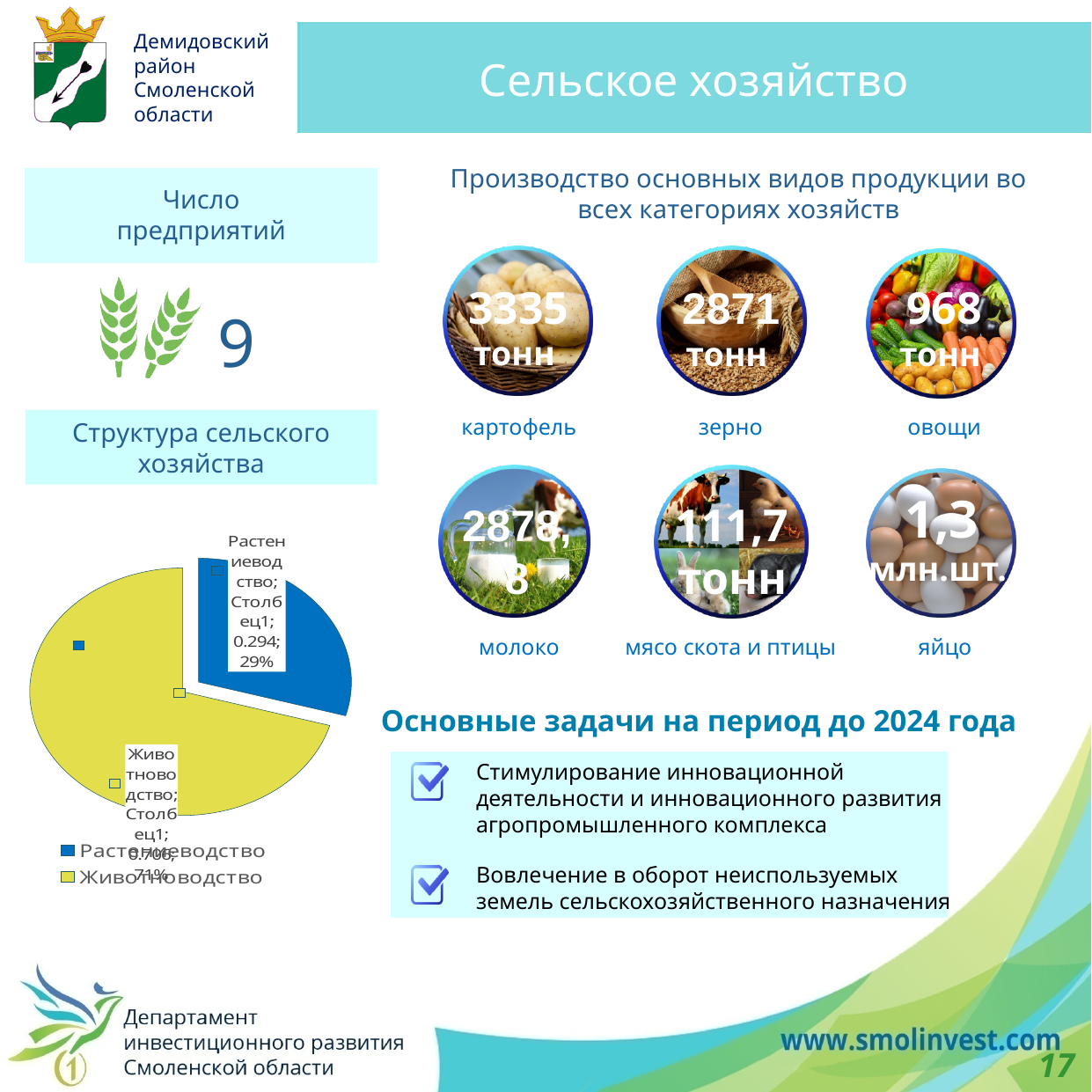
In the pie chart "Структура сельского хозяйства", what share does Животноводство have? 71% In the pie chart "Структура сельского хозяйства", what decimal value is shown in the data label for Растениеводство? 0.294 In the pie chart "Структура сельского хозяйства", by how many percentage points does Животноводство exceed Растениеводство? 42 In the pie chart "Структура сельского хозяйства", which is larger: Растениеводство or Животноводство? Животноводство What kind of chart is shown under the heading "Структура сельского хозяйства"? pie chart In the pie chart "Структура сельского хозяйства", what share does Растениеводство have? 29% Which slice of the pie chart "Структура сельского хозяйства" is the largest? Животноводство In the pie chart "Структура сельского хозяйства", what colour is the Растениеводство slice? blue In the pie chart "Структура сельского хозяйства", what colour is the Животноводство slice? yellow Which slice of the pie chart "Структура сельского хозяйства" is the smallest? Растениеводство How many slices does the pie chart "Структура сельского хозяйства" have? 2 How many entries does the legend of the pie chart "Структура сельского хозяйства" list? 2